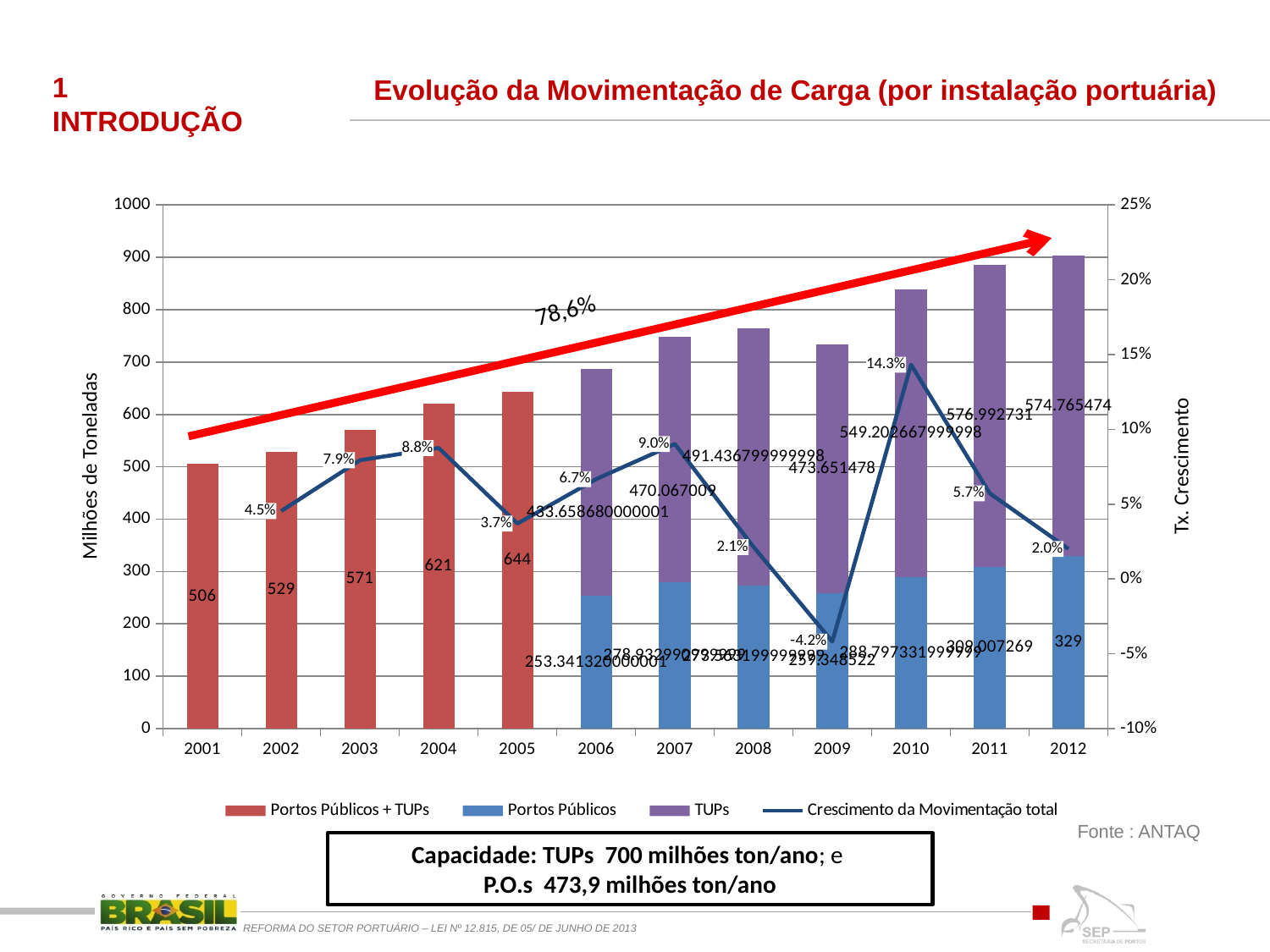
How many years are shown on the x axis? 12 In which year is the Crescimento da Movimentação total line at its highest? 2010 Is the total height of the stacked bar for 2010 greater or less than 800? greater What is the value for Portos Públicos + TUPs in 2001? 506 What is the value for Portos Públicos in 2012? 329 What is the value for Portos Públicos + TUPs in 2005? 644 What is the difference between the Portos Públicos + TUPs values for 2005 and 2001? 138 Which year has the larger Portos Públicos + TUPs value, 2003 or 2004? 2004 In which year is the Crescimento da Movimentação total line at its lowest? 2009 What is the Crescimento da Movimentação total value for 2010? 14.3% What is the Crescimento da Movimentação total value for 2009? -4.2% How many series does the legend list? 4